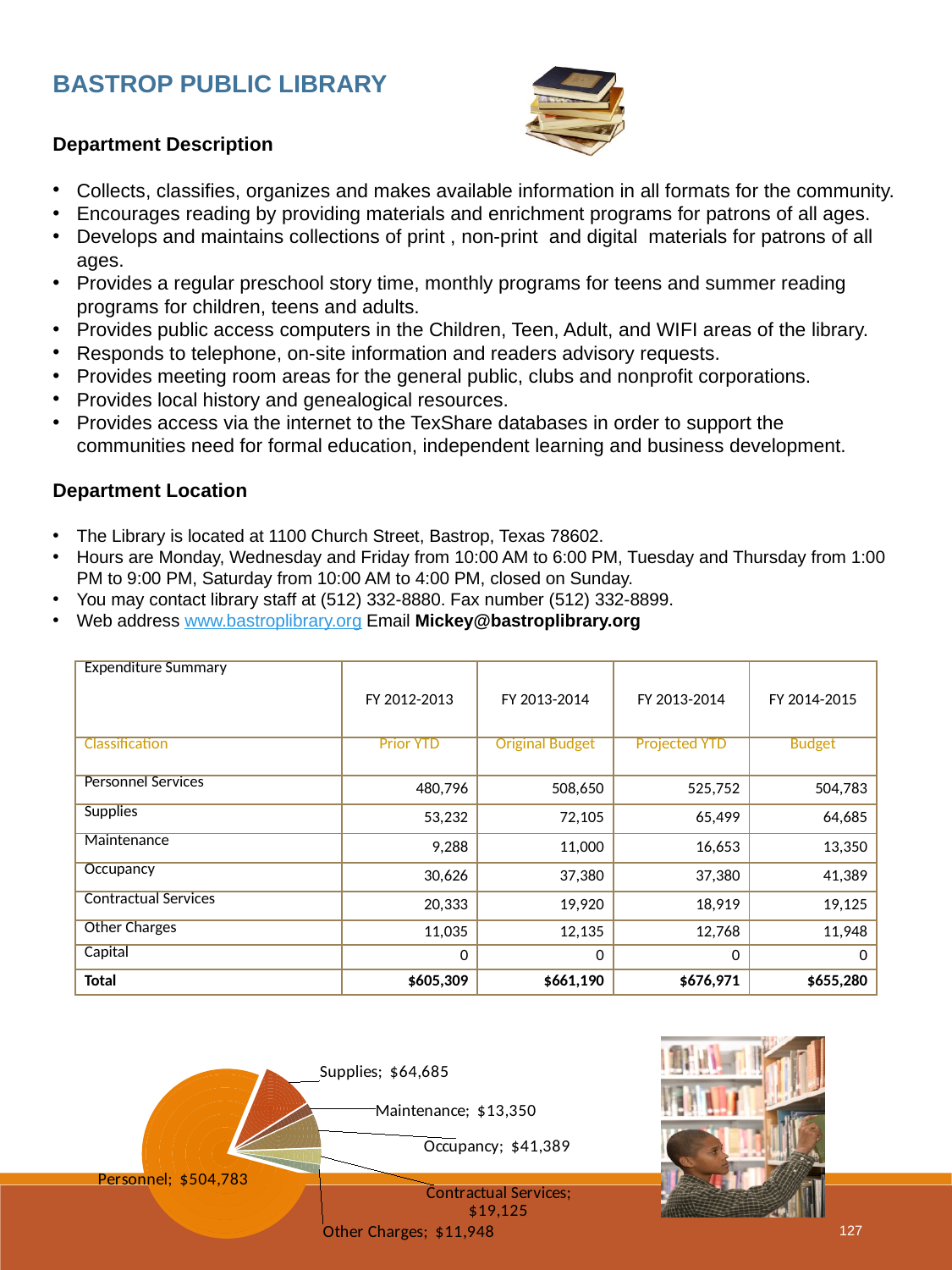
What is the difference between the Supplies and Maintenance values in the pie chart? $51,335 What is the value for Contractual Services in the pie chart? $19,125 What is the value for Personnel in the pie chart? $504,783 What is the value for Occupancy in the pie chart? $41,389 How many slices does the pie chart have? 6 What kind of chart is shown at the bottom of the slide? pie chart What is the total of all the values shown in the pie chart? $655,280 Which category has the smallest slice in the pie chart? Other Charges In the pie chart, which is larger: Supplies or Occupancy? Supplies What is the value for Supplies in the pie chart? $64,685 What is the value for Maintenance in the pie chart? $13,350 Which category has the largest slice in the pie chart? Personnel